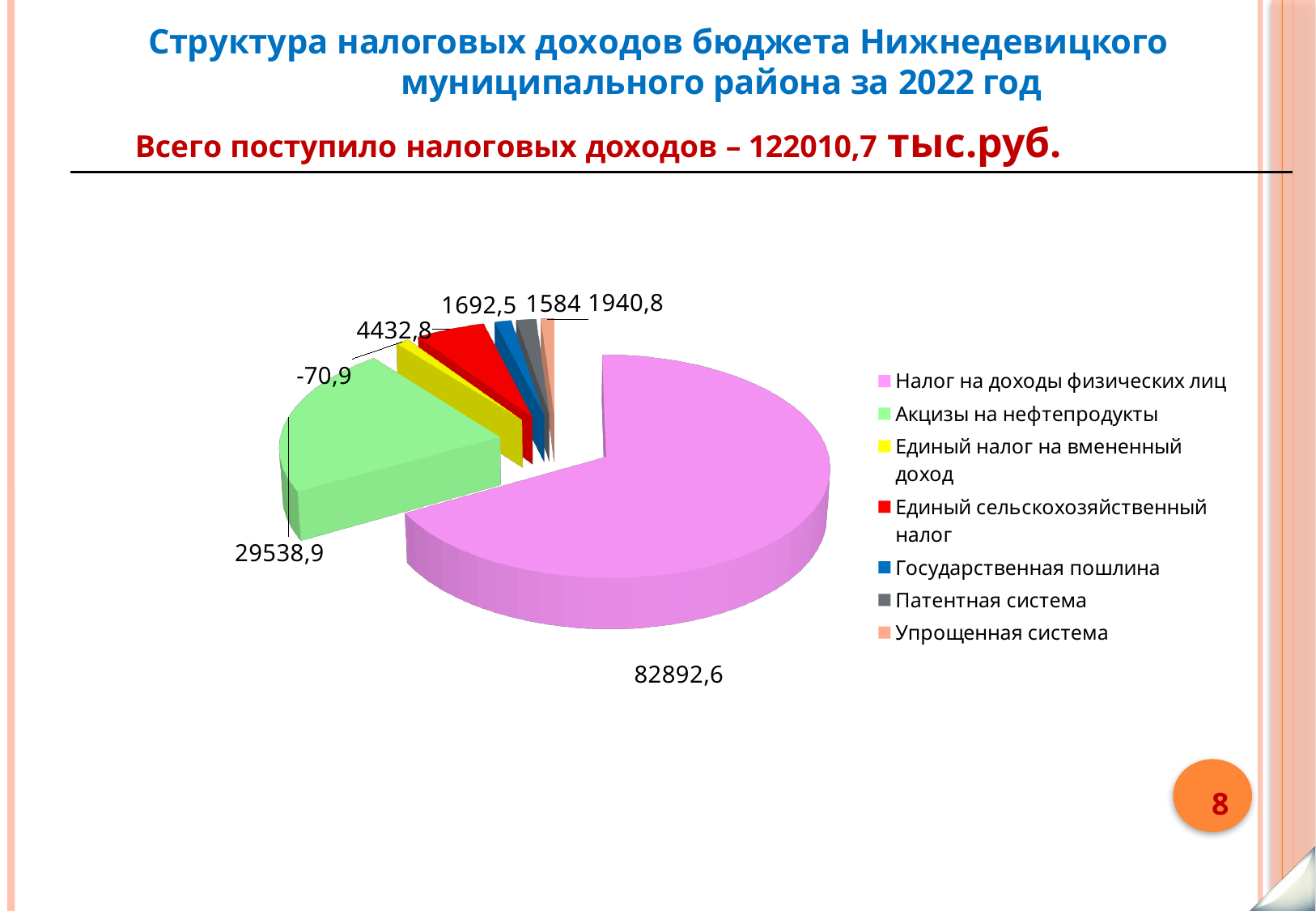
Which year does the chart title say the tax revenue structure refers to? 2022 What is the value shown for Налог на доходы физических лиц? 82892,6 What total amount of tax revenue does the slide state was received? 122010,7 тыс.руб. What is the smallest value labelled on the pie chart? -70,9 What kind of chart is shown on the slide? pie chart How many categories does the legend of the pie chart list? 7 What is the largest value labelled on the pie chart? 82892,6 What is the value shown for Акцизы на нефтепродукты? 29538,9 What is the difference between the value for Налог на доходы физических лиц and the value for Акцизы на нефтепродукты? 53353,7 Which category has the largest slice of the pie? Налог на доходы физических лиц Which is larger: the value for Налог на доходы физических лиц or the value for Акцизы на нефтепродукты? Налог на доходы физических лиц What colour is the slice for Налог на доходы физических лиц? pink